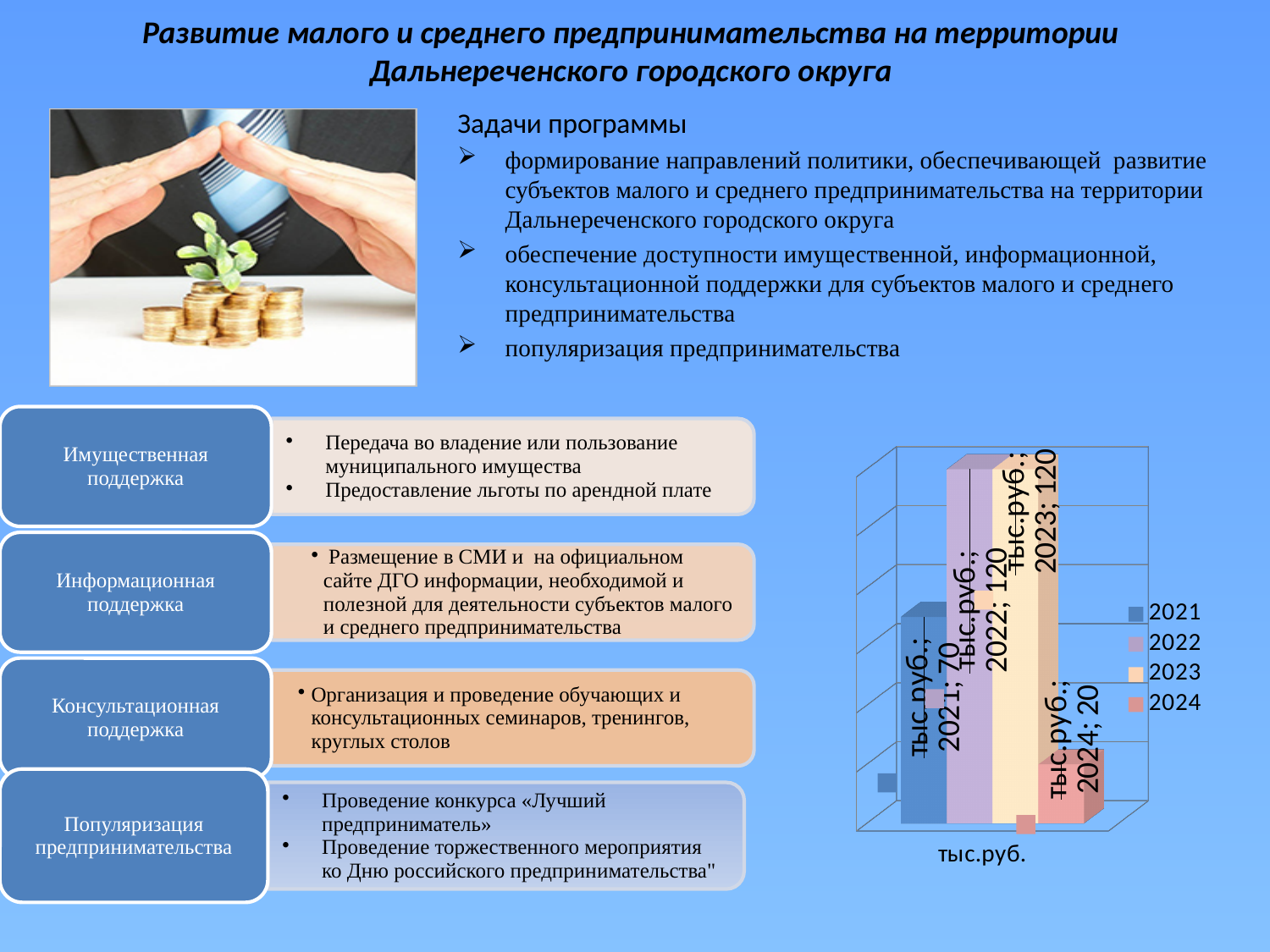
What is the value for 2022 on the chart? 120 Which is larger, the value for 2021 or the value for 2024? 2021 What is the difference between the values for 2022 and 2021? 50 How many bars are plotted on the chart? 4 Which year has the lowest value on the chart? 2024 What is the value for 2021 on the chart? 70 What is the value for 2024 on the chart? 20 What unit label is shown beneath the chart? тыс.руб. What is the difference between the values for 2021 and 2024? 50 What kind of chart is shown on the slide? bar chart How many entries does the chart legend list? 4 What is the value for 2023 on the chart? 120